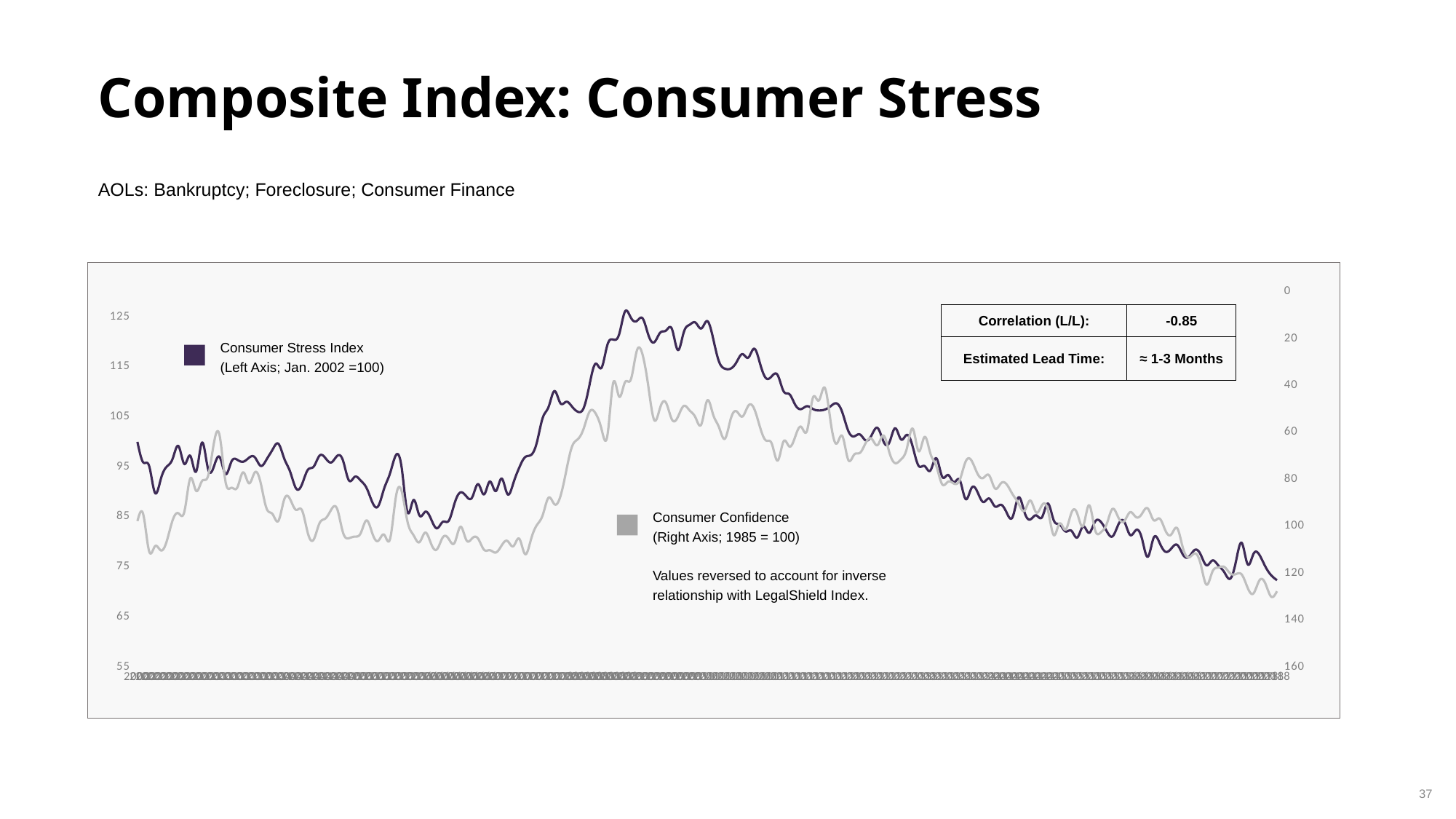
What is the largest tick value shown on the right axis? 160 How many series does the chart's legend list? 2 Is the Consumer Stress Index value at the left end of the chart greater or less than 85? greater What is the lowest tick value shown on the left axis? 55 What kind of chart is shown on the slide? line chart What is the highest tick value shown on the left axis? 125 Does the Consumer Stress Index rise or fall from its peak to the right end of the chart? fall What is the Correlation (L/L) value shown in the table on the chart? -0.85 What is the Estimated Lead Time shown in the table on the chart? ≈ 1-3 Months Is the value of the Consumer Stress Index at the right end of the chart greater or less than 85? less Is the peak value of the Consumer Stress Index greater or less than 115? greater Which series is plotted against the left axis? Consumer Stress Index